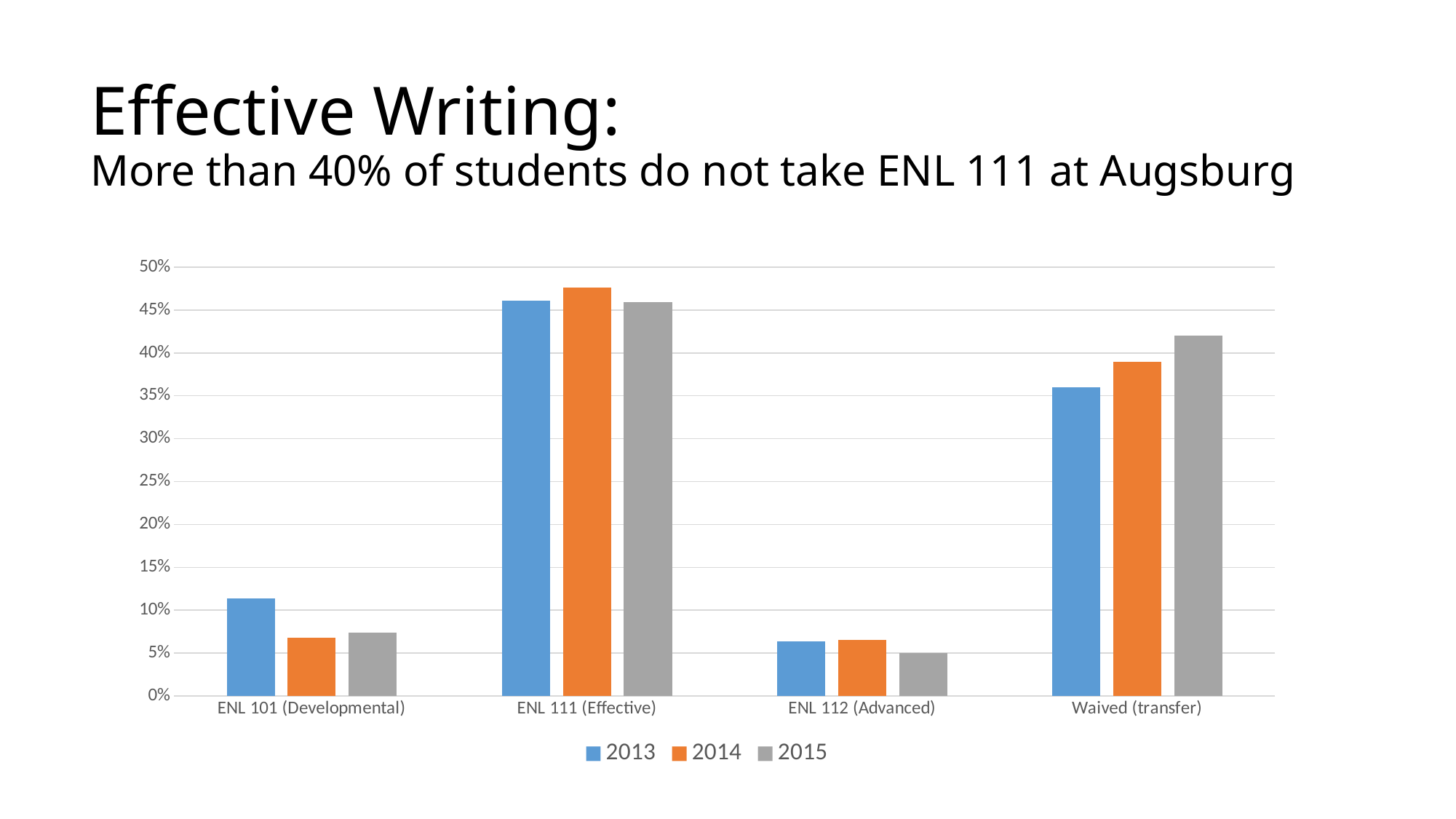
Is the value for ENL 101 (Developmental) in 2013 greater or less than 10%? greater Which category has the lowest value for 2015? ENL 112 (Advanced) Do the values for Waived (transfer) rise or fall from 2013 to 2015? rise How many categories are shown on the x axis? 4 Which is larger for Waived (transfer): the 2013 value or the 2015 value? 2015 Is the value for ENL 112 (Advanced) in 2015 greater or less than 10%? less Which colour represents the 2014 series in the legend? orange Is the value for ENL 111 (Effective) in 2014 greater or less than 45%? greater Which category has the highest value for 2014? ENL 111 (Effective) How many series does the legend list? 3 What kind of chart is shown on the slide? bar chart